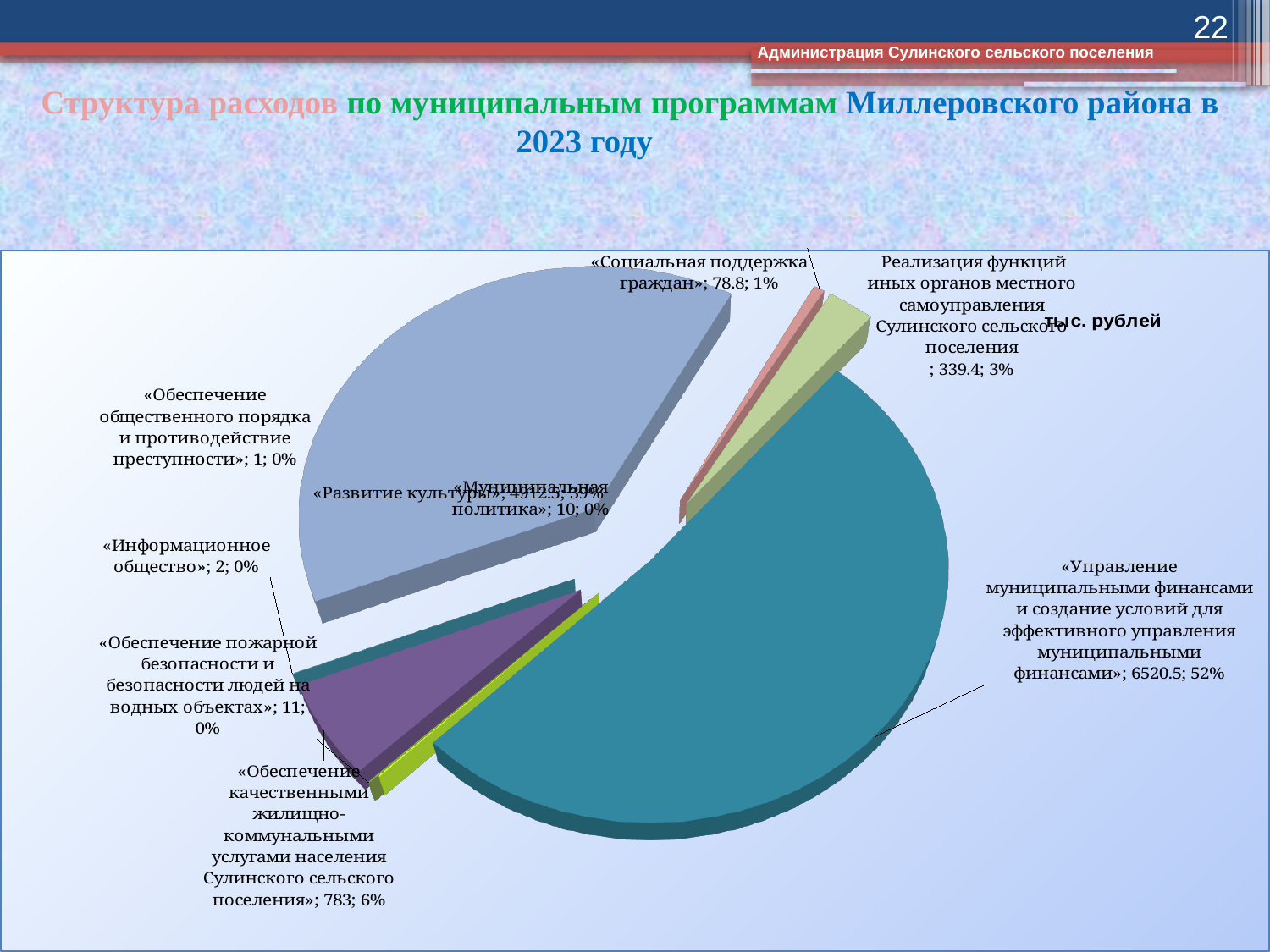
What is the value for Реализация функций иных органов местного самоуправления Сулинского сельского поселения? 339.4 Which is larger: «Социальная поддержка граждан» or Реализация функций иных органов местного самоуправления Сулинского сельского поселения? Реализация функций иных органов местного самоуправления Сулинского сельского поселения What is the value for «Обеспечение качественными жилищно-коммунальными услугами населения Сулинского сельского поселения»? 783 What is the value for «Управление муниципальными финансами и создание условий для эффективного управления муниципальными финансами»? 6520.5 What is the difference between the values for Реализация функций иных органов местного самоуправления Сулинского сельского поселения and «Социальная поддержка граждан»? 260.6 What share of the pie does «Обеспечение качественными жилищно-коммунальными услугами населения Сулинского сельского поселения» represent? 6% Which category has the largest slice of the pie? «Управление муниципальными финансами и создание условий для эффективного управления муниципальными финансами» How many categories are shown in the pie chart? 9 In what units are the values in the chart given? тыс. рублей What kind of chart is shown on the slide? Pie chart What is the value for «Социальная поддержка граждан»? 78.8 What share of the pie does «Управление муниципальными финансами и создание условий для эффективного управления муниципальными финансами» represent? 52%